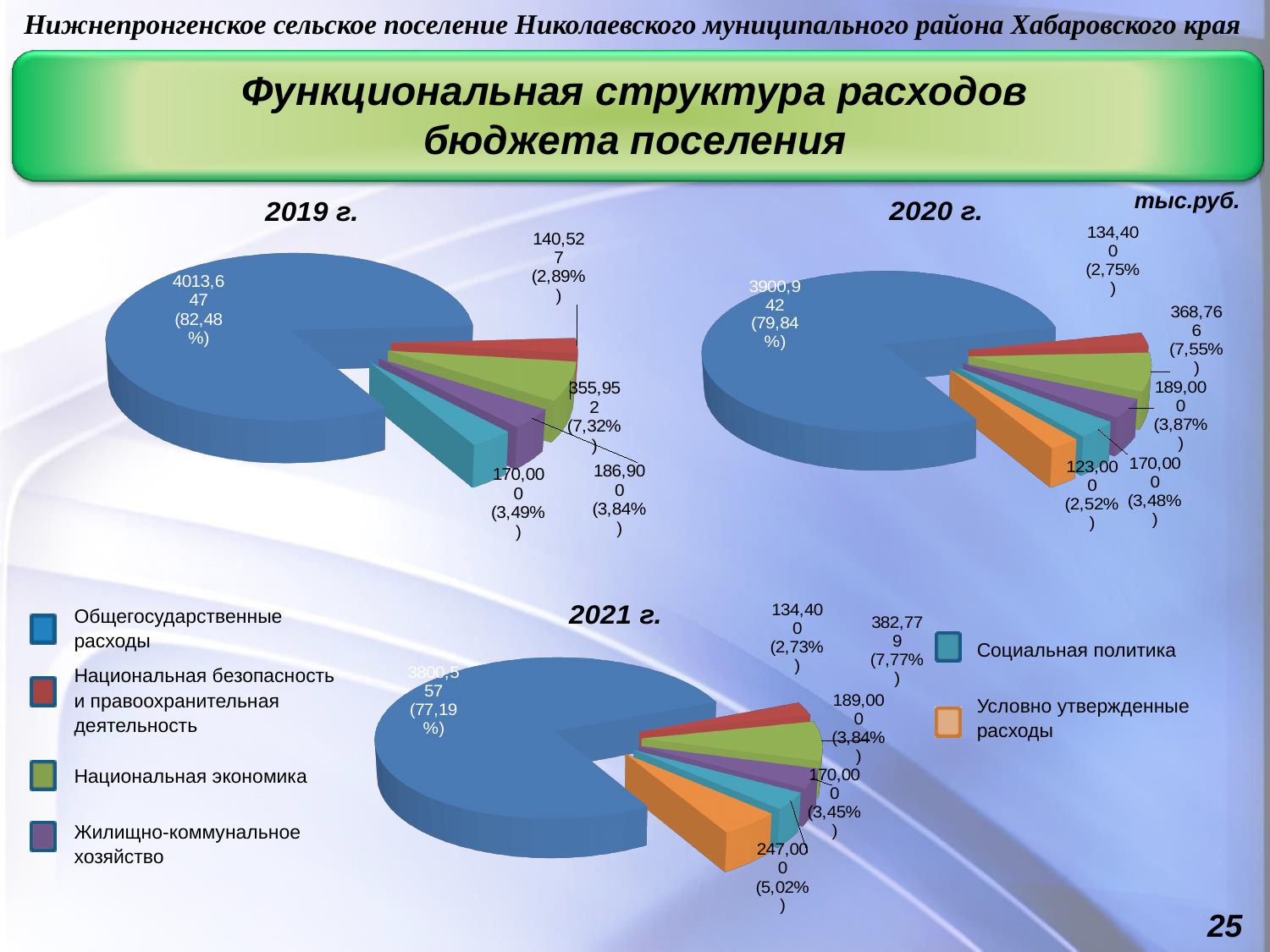
What type of charts are shown on the slide? Pie charts How many slices does the 2021 г. pie chart have? 6 How many slices does the 2019 г. pie chart have? 5 How many categories does the legend list? 6 In the 2020 г. chart, which category has the smallest slice? Условно утвержденные расходы In the 2020 г. chart, what is the value of the Общегосударственные расходы slice? 3900,942 In the 2021 г. chart, what is the value of the Условно утвержденные расходы slice? 247,000 In the 2021 г. chart, what is the difference between the Условно утвержденные расходы slice (247,000) and the Социальная политика slice (170,000)? 77,000 In the 2019 г. chart, which category has the largest slice? Общегосударственные расходы In the 2019 г. chart, what share of the pie is Общегосударственные расходы? 82,48% In the 2019 г. chart, what is the value of the Общегосударственные расходы slice? 4013,647 In the 2021 г. chart, what share of the pie is Общегосударственные расходы? 77,19%